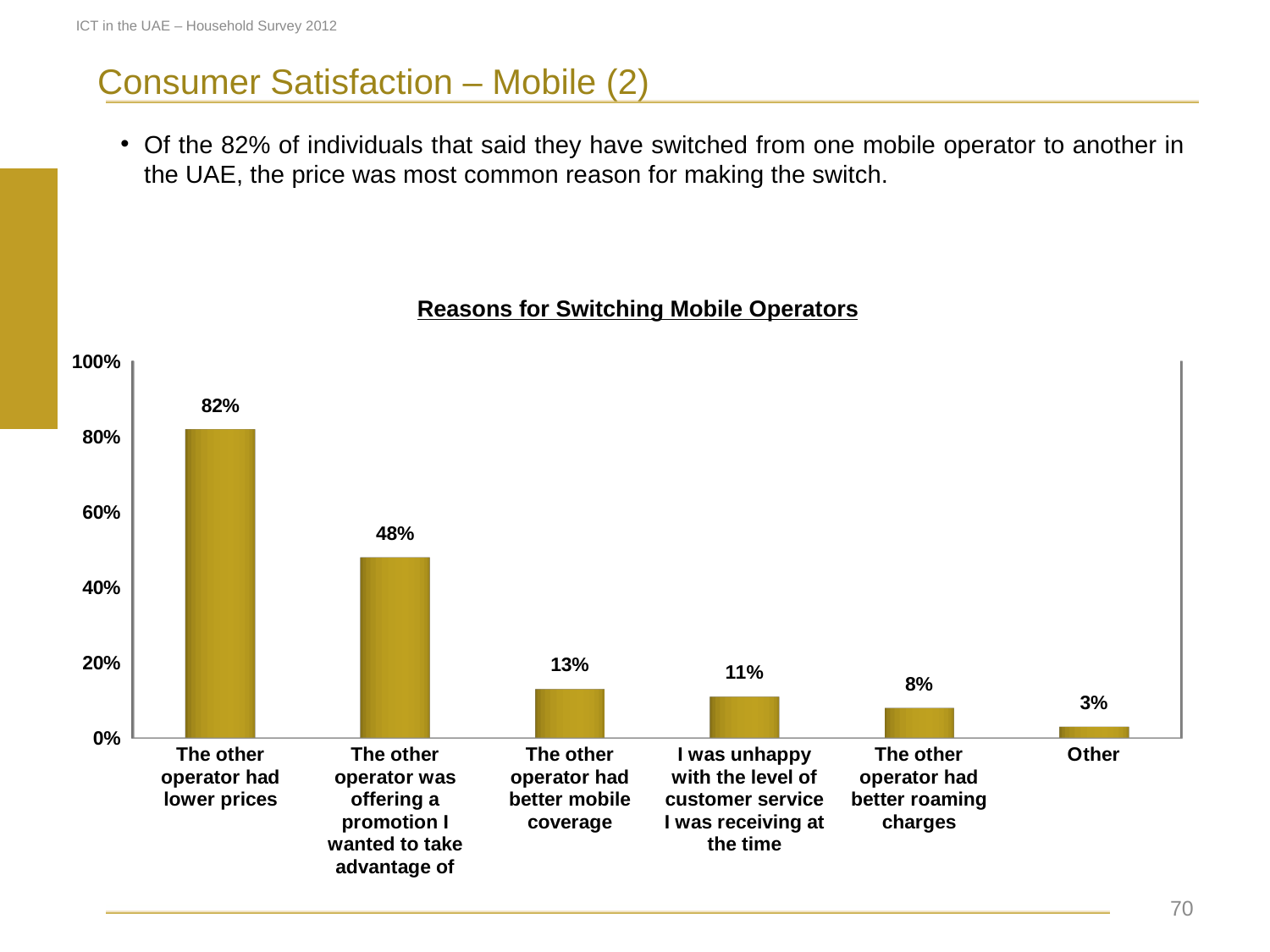
Which is larger: the value for unhappy with customer service or the value for better roaming charges? I was unhappy with the level of customer service I was receiving at the time What is the difference between the value for lower prices and the value for a promotion? 34% What is the value for 'Other'? 3% What is the difference between the value for better mobile coverage and the value for better roaming charges? 5% What kind of chart is shown on the slide? Bar chart How many reasons (categories) are shown in the chart? 6 What percentage of respondents said they switched because the other operator had lower prices? 82% What percentage cited better mobile coverage as a reason for switching? 13% Which reason for switching has the highest value? The other operator had lower prices Which reason for switching has the lowest value? Other What is the title of the chart? Reasons for Switching Mobile Operators What is the value for 'The other operator was offering a promotion I wanted to take advantage of'? 48%